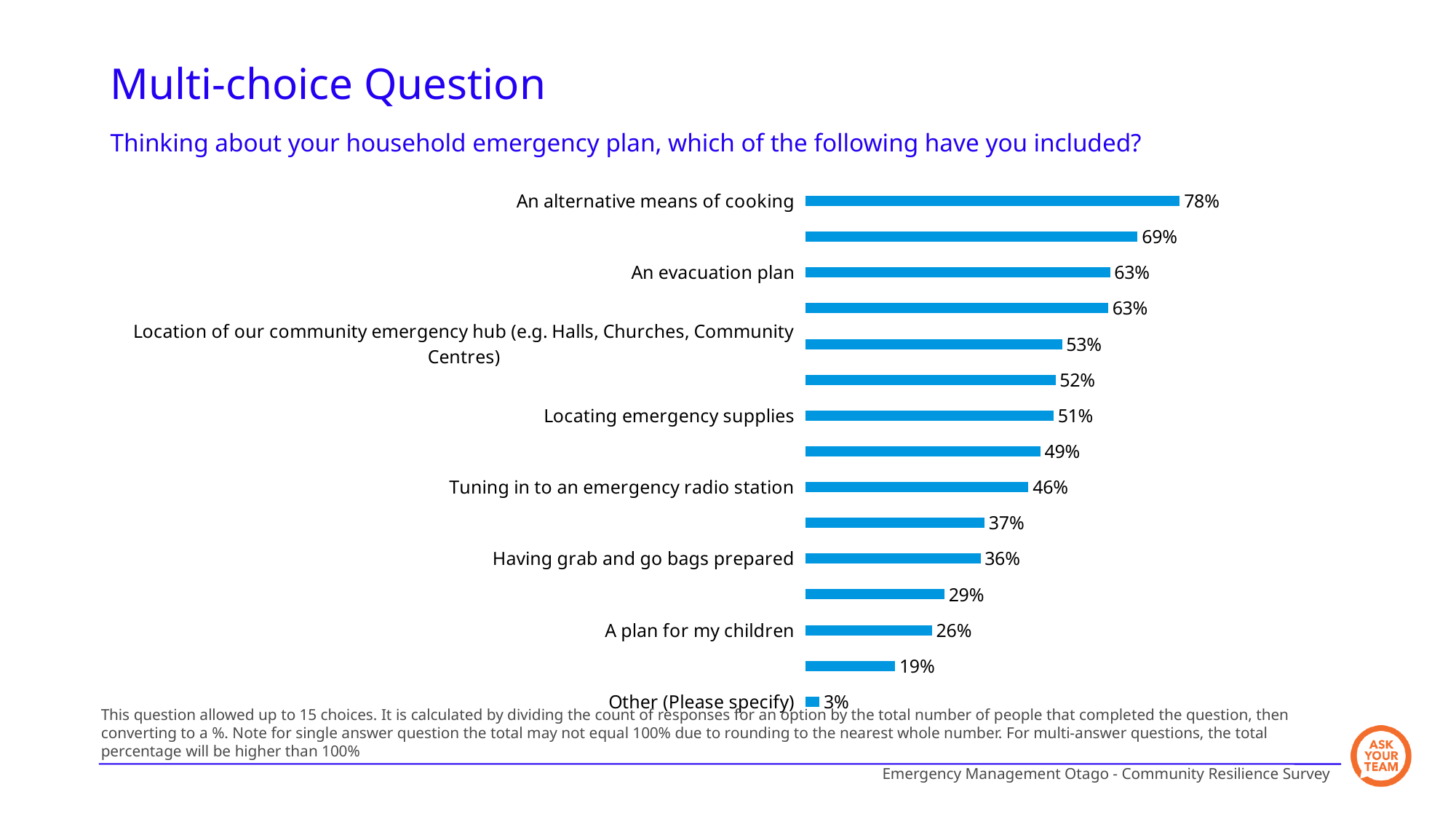
Which is larger: the value for "Locating emergency supplies" or the value for "Having grab and go bags prepared"? Locating emergency supplies What is the difference in percentage points between "An alternative means of cooking" and "An evacuation plan"? 15 What is the value shown for "A plan for my children"? 26% What percentage of respondents included an alternative means of cooking in their household emergency plan? 78% What type of chart is shown on the slide? Bar chart Which option has the lowest percentage in the chart? Other (Please specify) What percentage is shown for "Locating emergency supplies"? 51% What is the value shown for "An evacuation plan"? 63% Which option has the highest percentage in the chart? An alternative means of cooking How many bars are plotted in the chart? 15 What is the value for "Tuning in to an emergency radio station"? 46% What percentage of respondents reported having grab and go bags prepared? 36%